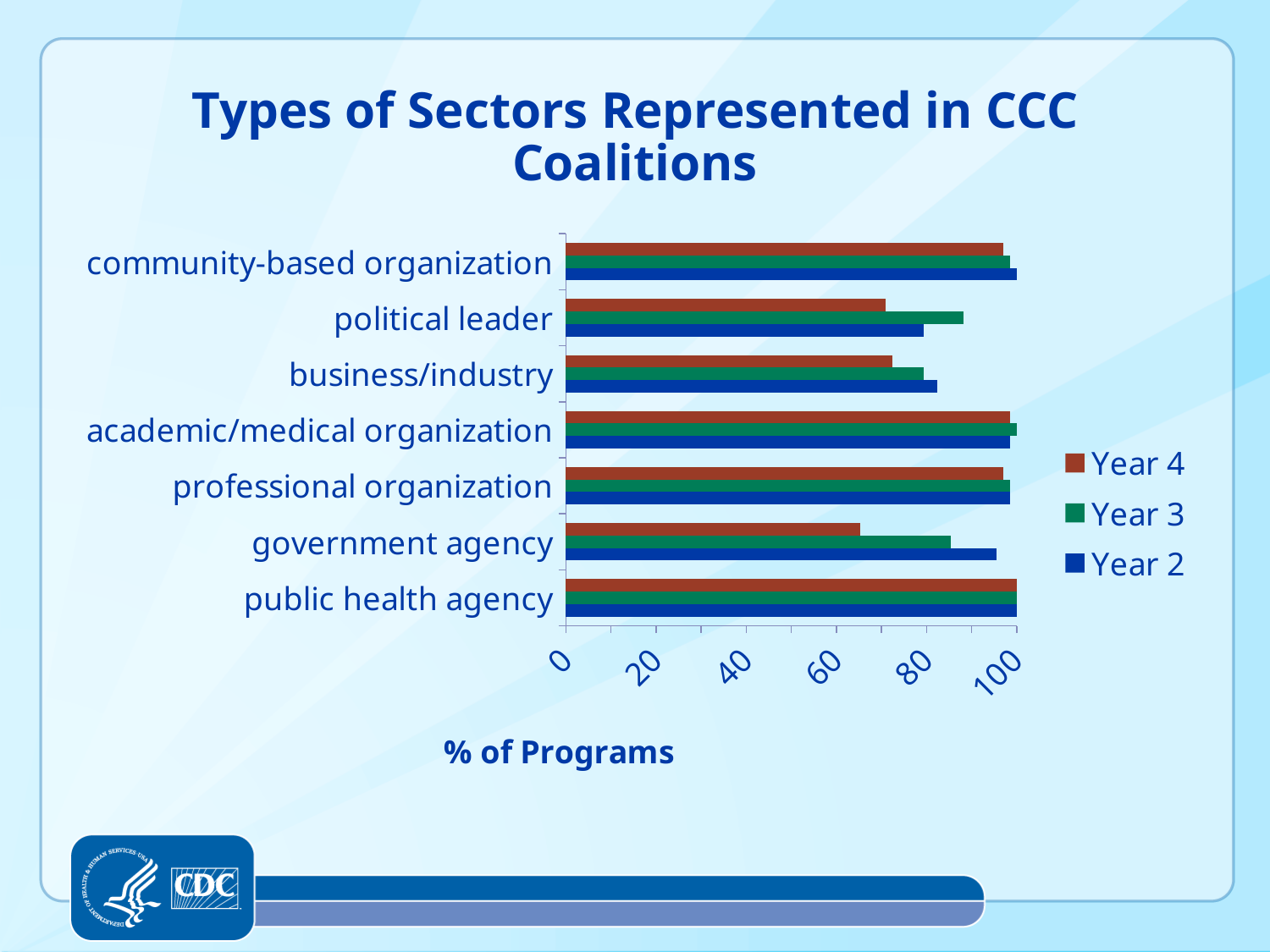
Is the Year 3 value for political leader greater or less than 80? greater How many sector categories are plotted on the chart? 7 For government agency, which is larger: the Year 2 value or the Year 4 value? Year 2 What is the label of the horizontal axis? % of Programs What kind of chart is shown on the slide? bar chart How many series does the legend list? 3 For political leader, which is larger: the Year 3 value or the Year 4 value? Year 3 Is the Year 4 value for political leader greater or less than 60? greater Which sector has the lowest Year 4 value? government agency What is the Year 2 value for public health agency? 100 Which colour represents Year 2 in the legend? blue Is the Year 4 value for government agency greater or less than 80? less